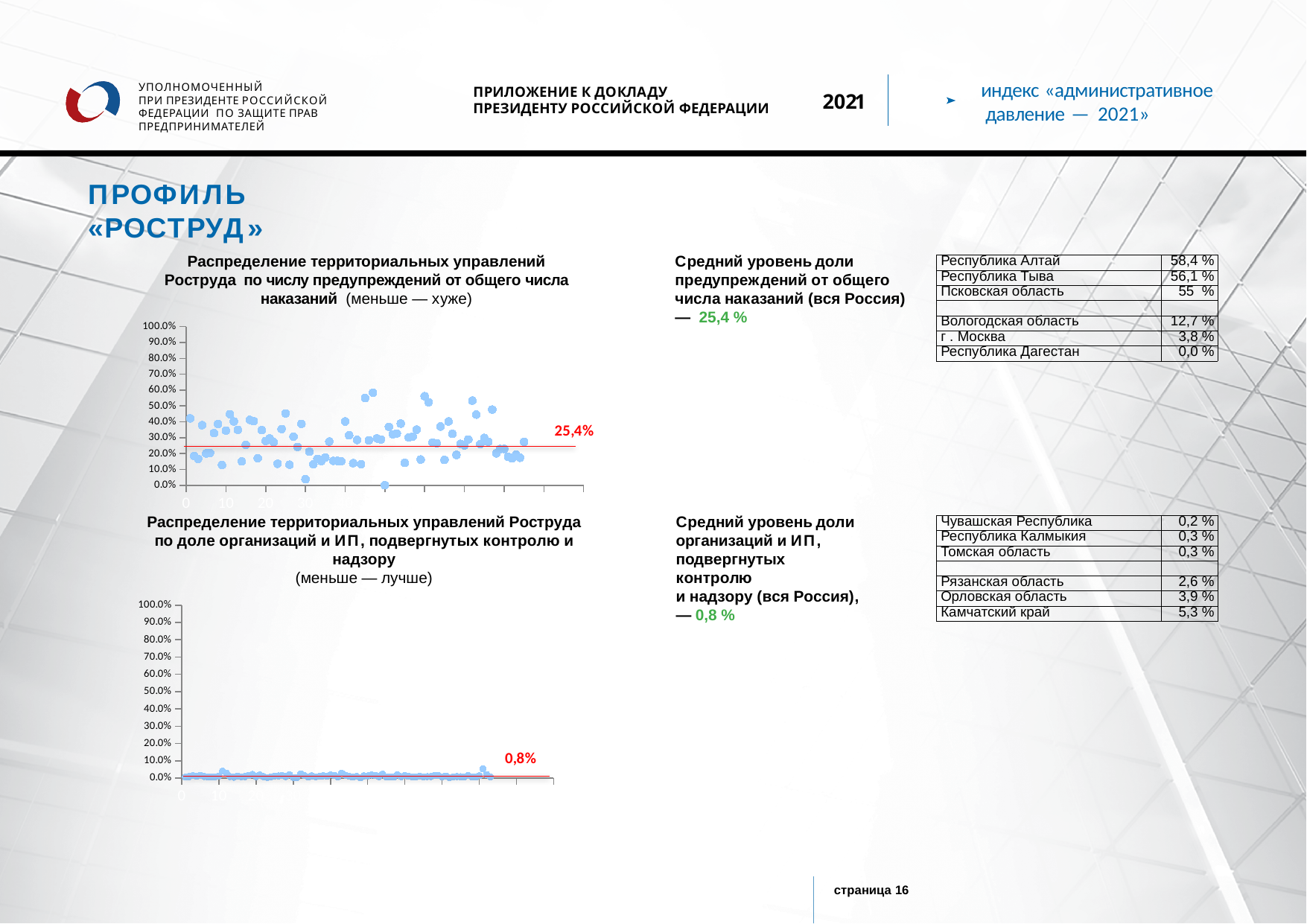
What is the highest tick value shown on the y axis of the top chart? 100.0% Which chart has the higher labelled average line, the top chart or the bottom chart? The top chart In the top chart, is the highest plotted point greater or less than 70.0%? less What colour are the plotted points in the top chart? Light blue What is the difference between the average value labelled on the top chart and the average value labelled on the bottom chart? 24,6% In the bottom chart, what value is printed on the horizontal average line? 0,8% In the top chart, what value is printed on the horizontal average line? 25,4% What kind of chart is the top chart, 'Распределение территориальных управлений Роструда по числу предупреждений от общего числа наказаний'? Scatter chart What kind of chart is the bottom chart, 'Распределение территориальных управлений Роструда по доле организаций и ИП, подвергнутых контролю и надзору'? Scatter chart In the bottom chart, is the highest plotted point greater or less than 20.0%? less In the top chart, is the lowest plotted point greater or less than 10.0%? less